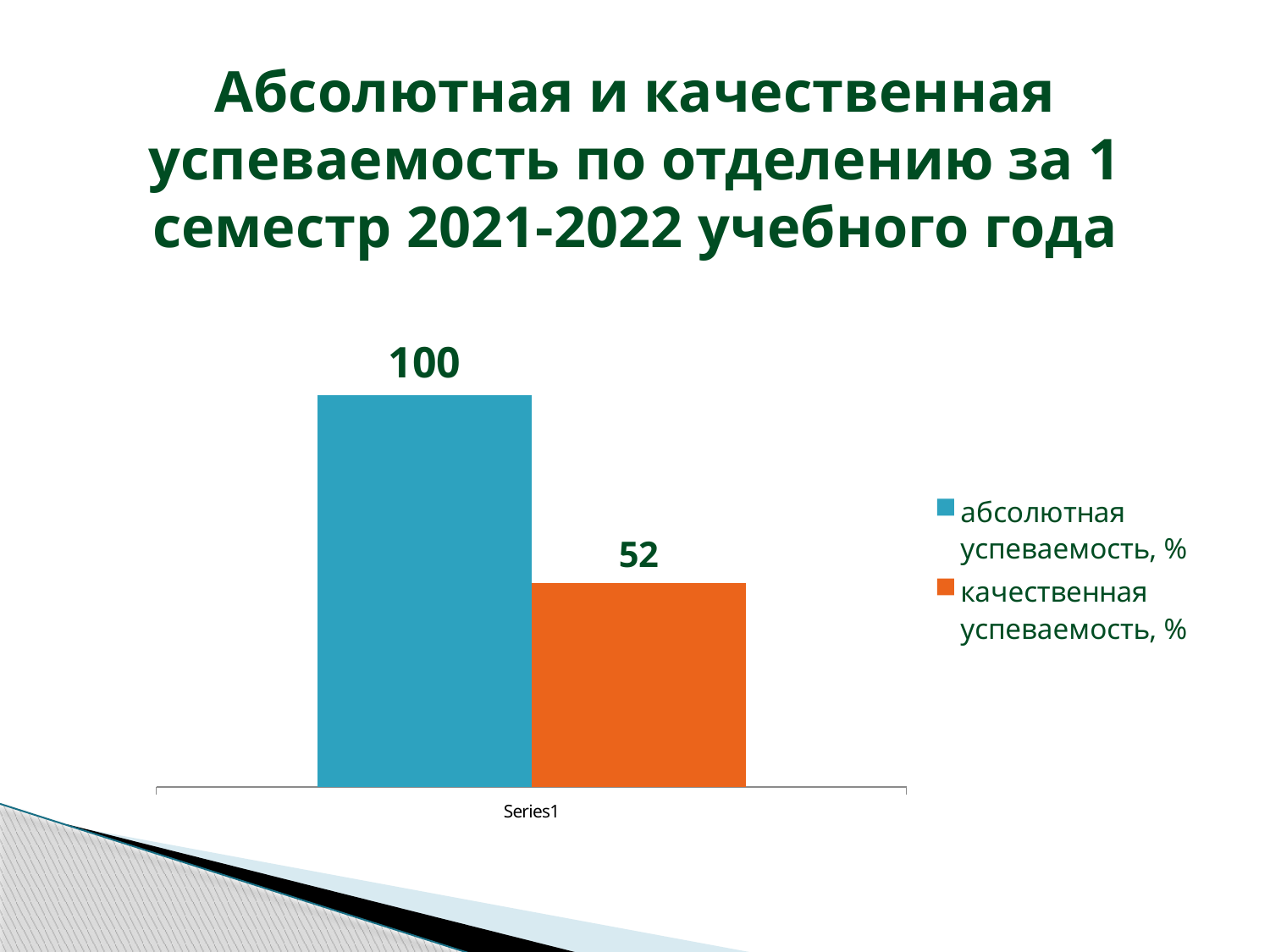
How many series does the legend list? 2 Which is larger: абсолютная успеваемость, % or качественная успеваемость, %? абсолютная успеваемость, % Which series has the lowest value? качественная успеваемость, % What colour is the bar for качественная успеваемость, %? orange How many bars are plotted on the chart? 2 What kind of chart is shown on the slide? bar chart What is the value for качественная успеваемость, %? 52 What is the value for абсолютная успеваемость, %? 100 What is the category label shown on the x axis? Series1 Which series has the highest value? абсолютная успеваемость, % What is the difference between абсолютная успеваемость, % and качественная успеваемость, %? 48